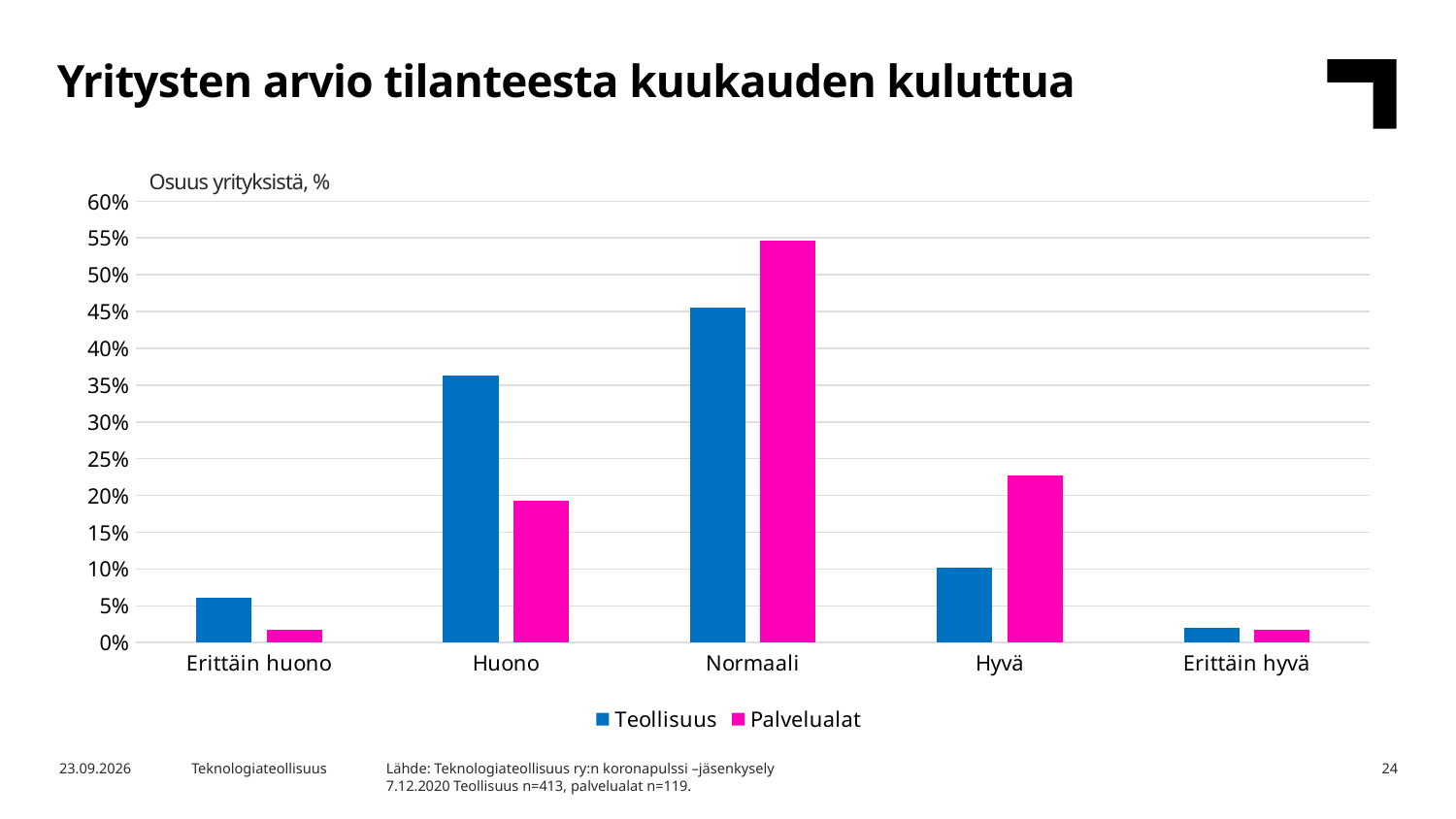
In the Hyvä category, which series has the larger value, Teollisuus or Palvelualat? Palvelualat What is the label shown above the y axis of the chart? Osuus yrityksistä, % How many categories are shown on the x axis of the chart? 5 Which category has the highest value for Palvelualat? Normaali Which category has the highest value for Teollisuus? Normaali In the Huono category, which series has the larger value, Teollisuus or Palvelualat? Teollisuus Which category has the lowest value for Teollisuus? Erittäin hyvä Is the Palvelualat value for Normaali greater or less than 50%? greater Is the Teollisuus value for Huono greater or less than 30%? greater How many series does the chart's legend list? 2 In the Normaali category, which series has the larger value, Teollisuus or Palvelualat? Palvelualat What kind of chart is shown on the slide? bar chart